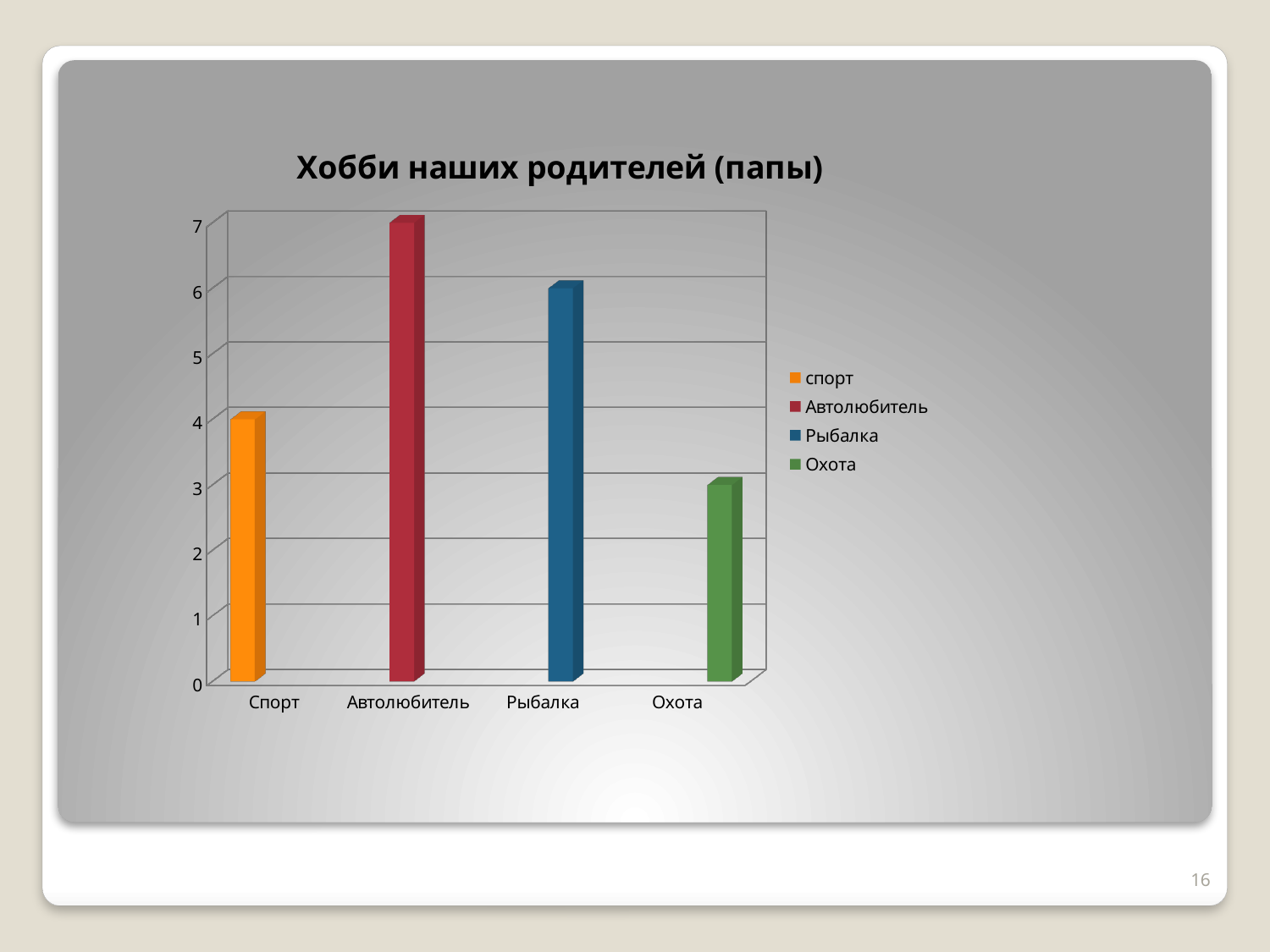
Which category has the lowest value? Охота What is the value for Охота? 3 How many categories are shown on the x axis? 4 What is the title of the chart? Хобби наших родителей (папы) What is the difference between the values for Автолюбитель and Охота? 4 What is the value for Рыбалка? 6 How many entries does the legend list? 4 Which is larger, the value for Спорт or the value for Рыбалка? Рыбалка Which category has the highest value? Автолюбитель What kind of chart is shown on the slide? bar chart What is the value for Автолюбитель? 7 What is the value for Спорт? 4